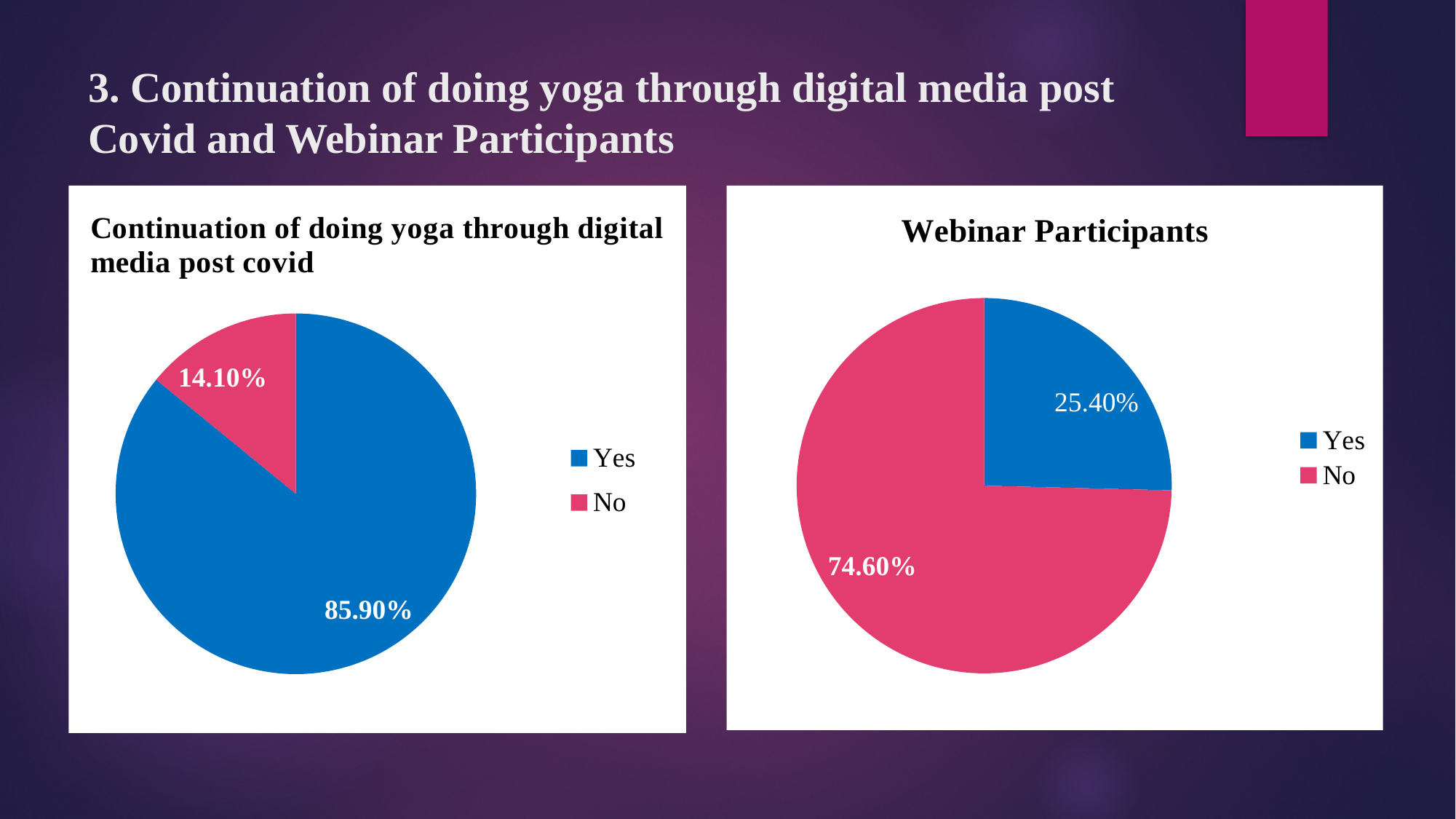
How many categories does the legend of the 'Continuation of doing yoga through digital media post covid' chart list? 2 In the 'Webinar Participants' chart, what colour is the No slice? Pink In the 'Continuation of doing yoga through digital media post covid' chart, what is the difference between the Yes and No percentages? 71.80% In the 'Webinar Participants' chart, which is larger, Yes or No? No In the 'Webinar Participants' chart, which category has the smallest slice? Yes What type of chart is the 'Webinar Participants' chart? Pie chart In the 'Webinar Participants' chart, what percentage is shown for Yes? 25.40% In the 'Webinar Participants' chart, what percentage is shown for No? 74.60% In the 'Webinar Participants' chart, what is the difference between the No and Yes percentages? 49.20% In the 'Continuation of doing yoga through digital media post covid' chart, which category has the largest slice? Yes In the 'Continuation of doing yoga through digital media post covid' chart, what percentage is shown for Yes? 85.90% In the 'Continuation of doing yoga through digital media post covid' chart, what percentage is shown for No? 14.10%